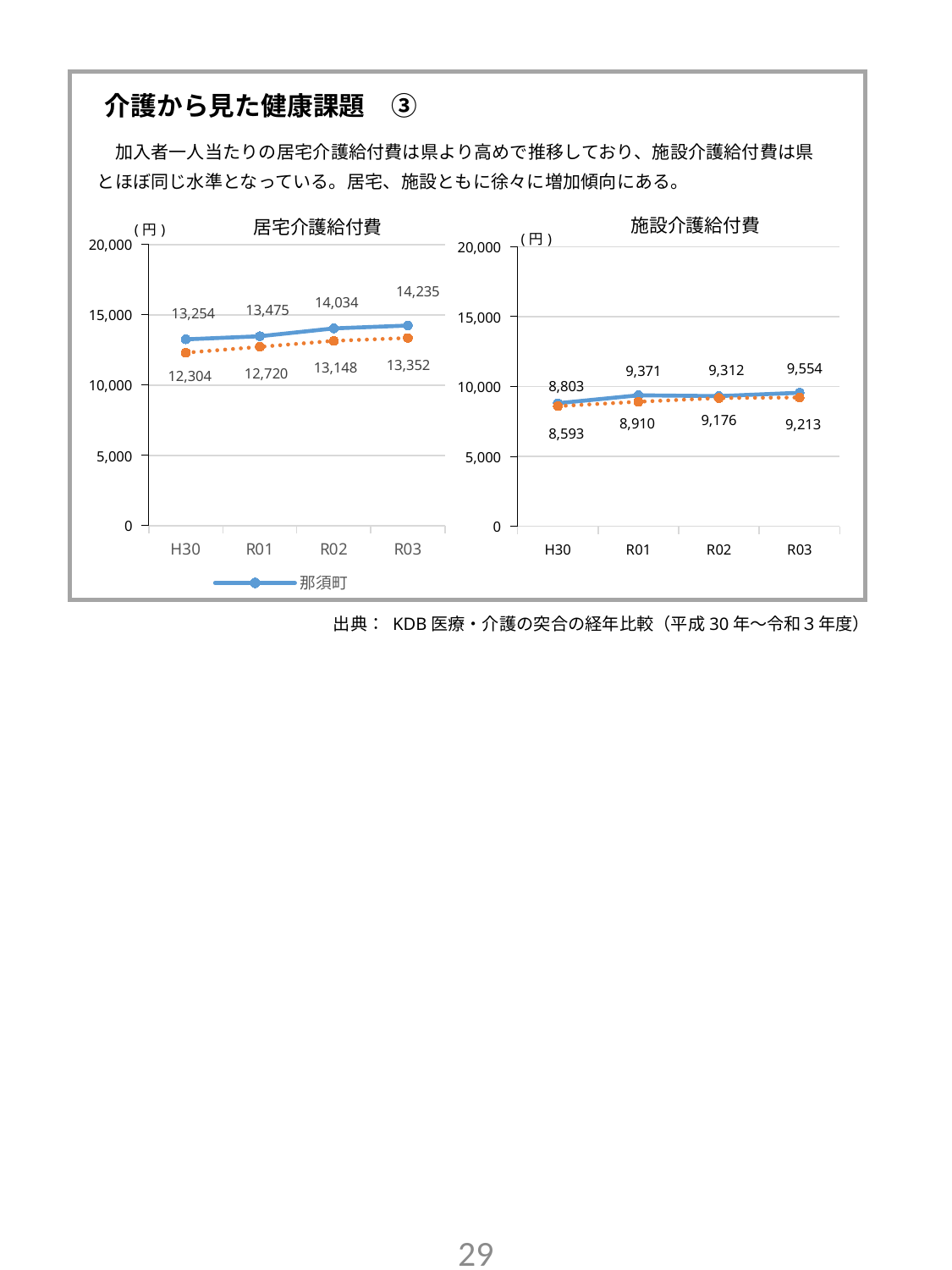
In the 施設介護給付費 chart, what is the value for 那須町 in R01? 9,371 How many years are shown on the x axis of the 居宅介護給付費 chart? 4 In the 居宅介護給付費 chart, in which year is the 那須町 value highest? R03 In the 居宅介護給付費 chart, what is the difference between the 那須町 value in R03 and in H30? 981 In the 居宅介護給付費 chart, what is the value for 那須町 in H30? 13,254 What type of chart is the 施設介護給付費 chart? Line chart In the 居宅介護給付費 chart, does the 那須町 line rise or fall from H30 to R03? Rise In the 居宅介護給付費 chart, what is the value for 那須町 in R03? 14,235 In the 施設介護給付費 chart, which is larger for 那須町: the value in R01 or the value in R02? R01 In the 施設介護給付費 chart, in which year is the 那須町 value lowest? H30 In the 施設介護給付費 chart, what is the difference between the 那須町 value and the orange dotted line value in R01? 461 In the 施設介護給付費 chart, what is the value of the orange dotted line in R03? 9,213